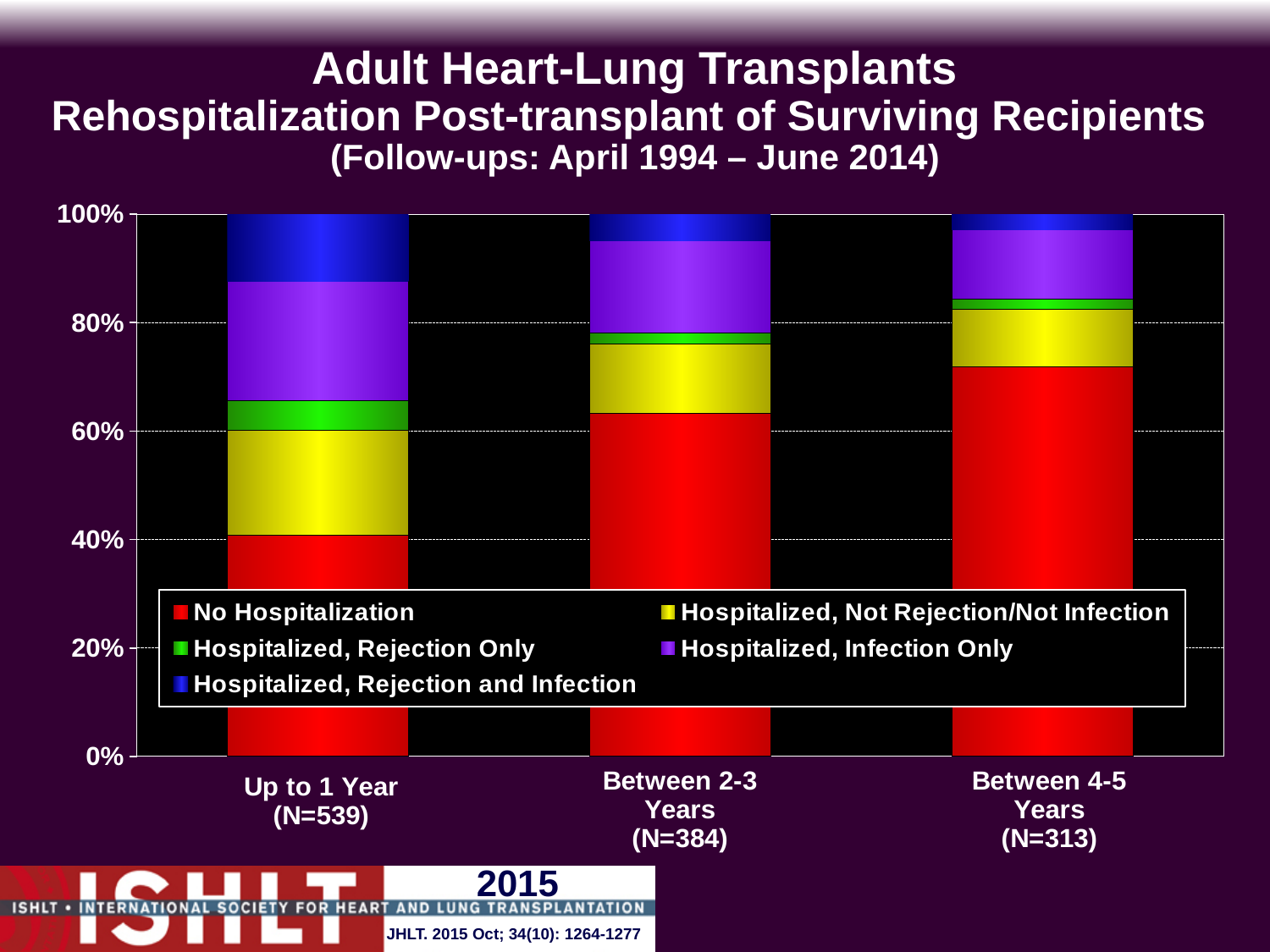
Which has the larger share of Hospitalized, Rejection and Infection: Up to 1 Year or Between 4-5 Years? Up to 1 Year Is the No Hospitalization share for Between 4-5 Years greater or less than 60%? greater What is the total height of each stacked bar? 100% How many series does the legend list? 5 Which follow-up category has the smallest share of No Hospitalization? Up to 1 Year What is the N for the Between 2-3 Years category? N=384 Is the No Hospitalization share for Up to 1 Year greater or less than 60%? less How many follow-up time categories are shown on the x axis? 3 Is the No Hospitalization share for Between 2-3 Years greater or less than 40%? greater Does the share of No Hospitalization rise or fall from Up to 1 Year to Between 4-5 Years? rise What kind of chart is shown on the slide? Stacked bar chart Which follow-up category has the largest share of No Hospitalization? Between 4-5 Years